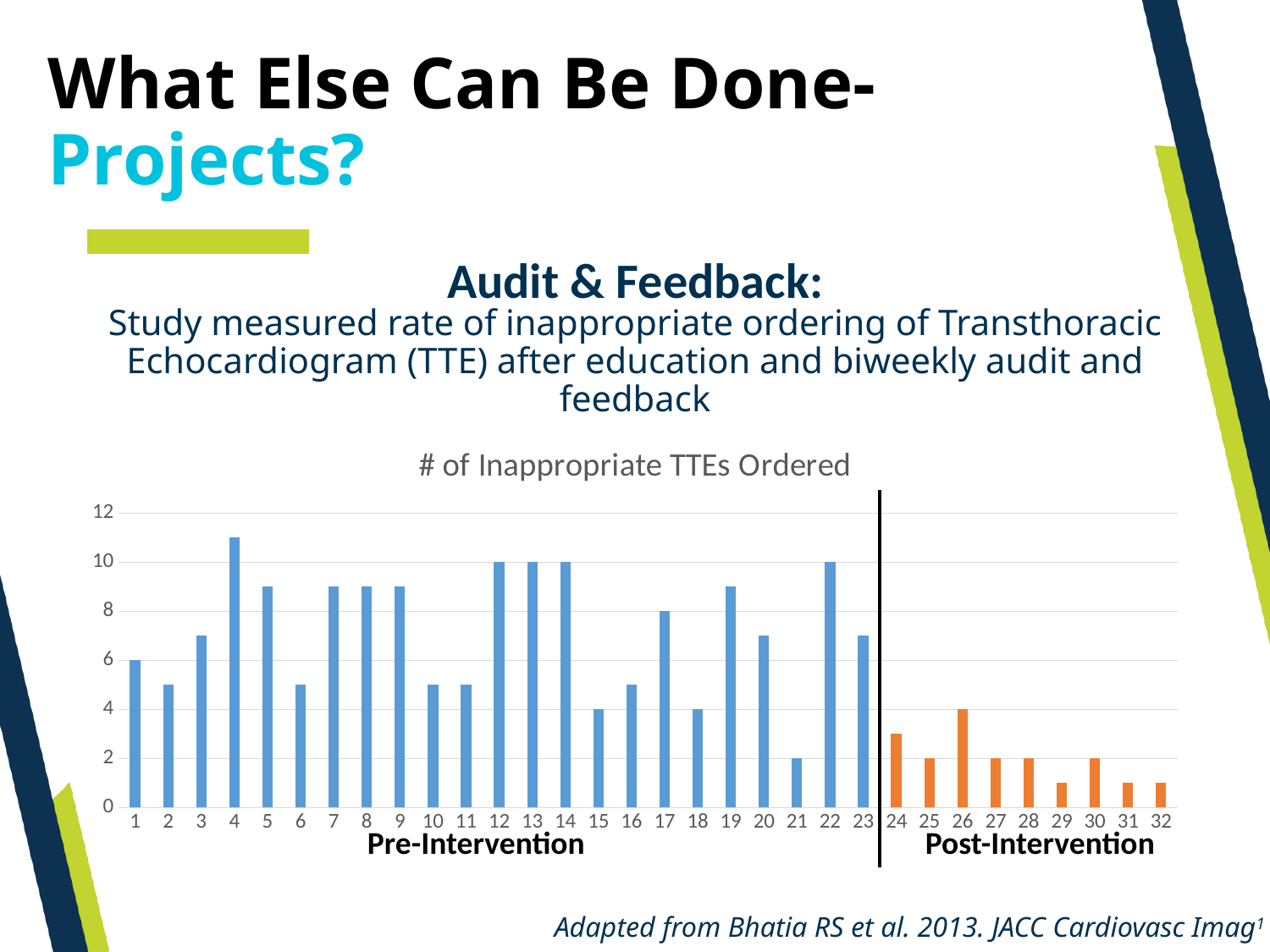
Which period has the highest number of inappropriate TTEs ordered? 4 How many categories (time periods) are plotted along the x axis? 32 Which is larger, the value for period 22 or the value for period 25? period 22 What is the value for period 26? 4 What kind of chart is shown on the slide? bar chart Is the value for period 4 greater or less than 10? greater What is the title of the chart? # of Inappropriate TTEs Ordered What is the value for period 21? 2 What is the value for period 12? 10 Do the values generally rise or fall after the intervention line between periods 23 and 24? fall What is the value for period 1? 6 Is the value for period 24 greater or less than 4? less